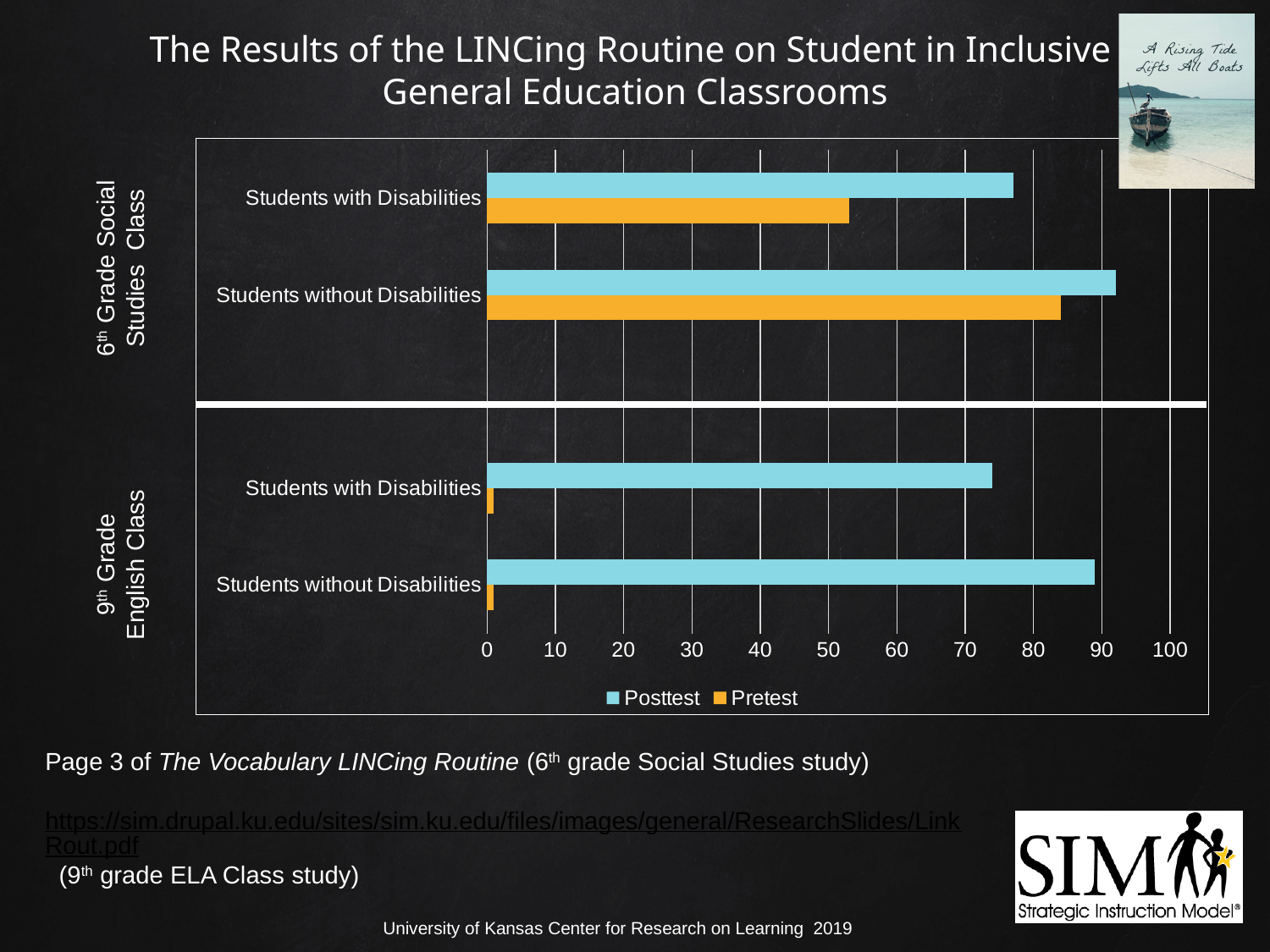
Is the Posttest value for Students without Disabilities in the 6th Grade Social Studies Class greater or less than 90? greater Which colour represents the Pretest series in the chart? orange Is the Pretest value for Students without Disabilities in the 9th Grade English Class greater or less than 10? less Is the Posttest value for Students with Disabilities in the 9th Grade English Class greater or less than 70? greater How many category bars groups are plotted in the chart across both class sections? 4 How many series does the chart legend list? 2 In the 6th Grade Social Studies Class, which is larger for Students with Disabilities: the Posttest or the Pretest value? Posttest Which bar in the chart has the highest value? Posttest for Students without Disabilities in the 6th Grade Social Studies Class In the 9th Grade English Class, which group has the higher Posttest value: Students with Disabilities or Students without Disabilities? Students without Disabilities What kind of chart is shown on the slide? bar chart What are the two series named in the chart legend? Posttest and Pretest